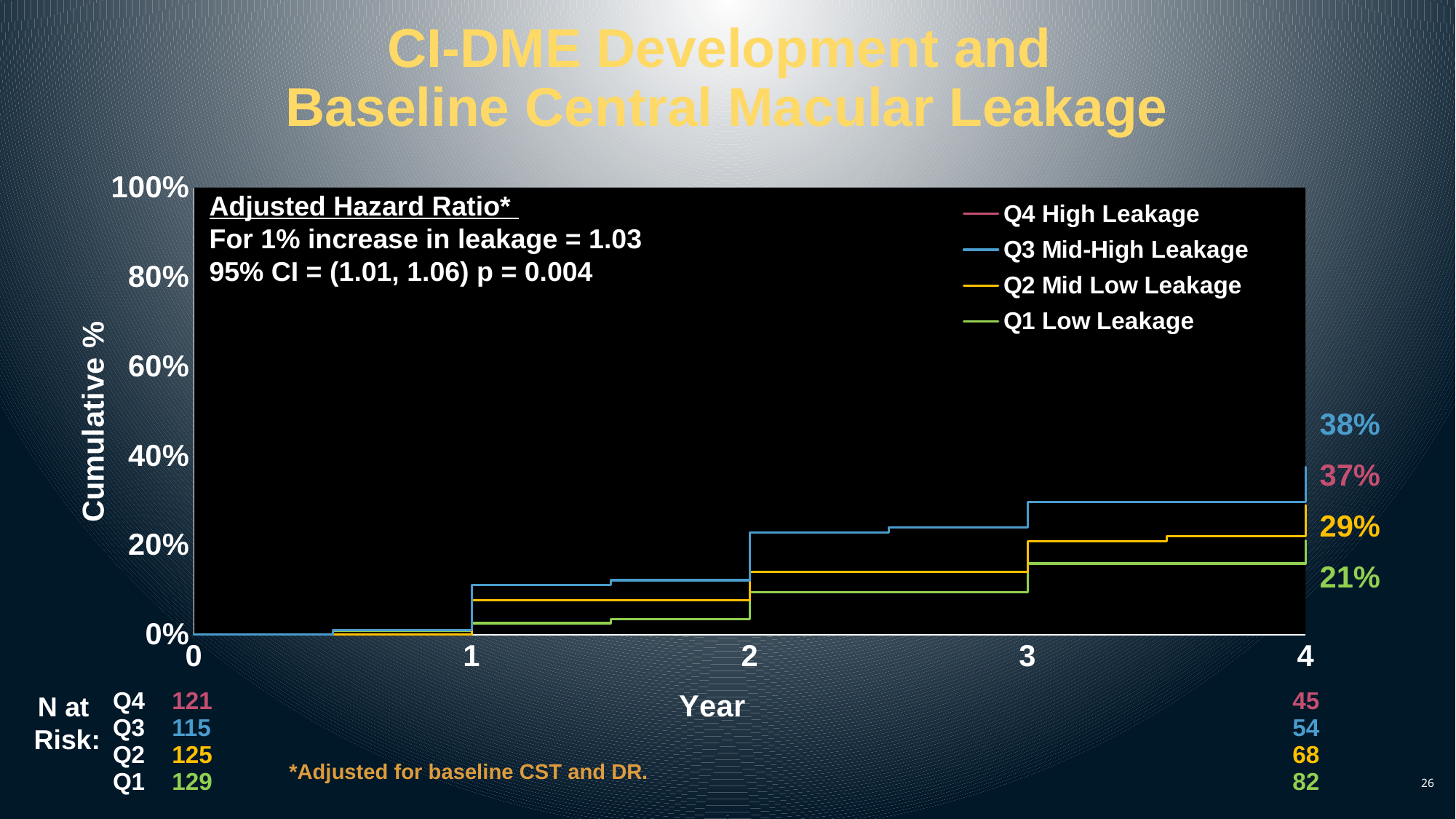
Is the cumulative % for Q1 Low Leakage at year 3 greater or less than 20%? less What is the cumulative % for Q3 Mid-High Leakage at year 4? 38% What is the cumulative % for Q2 Mid Low Leakage at year 4? 29% Do the cumulative % values rise or fall as the year increases? rise Which series has the lowest cumulative % at year 4? Q1 Low Leakage What is the cumulative % for Q4 High Leakage at year 4? 37% What kind of chart is shown on the slide? line chart What is the cumulative % for Q1 Low Leakage at year 4? 21% How many series does the legend list? 4 What is the difference between the year-4 cumulative % for Q3 Mid-High Leakage and Q1 Low Leakage? 17 percentage points At year 4, which has the larger cumulative %: Q2 Mid Low Leakage or Q1 Low Leakage? Q2 Mid Low Leakage Which series has the highest cumulative % at year 4? Q3 Mid-High Leakage